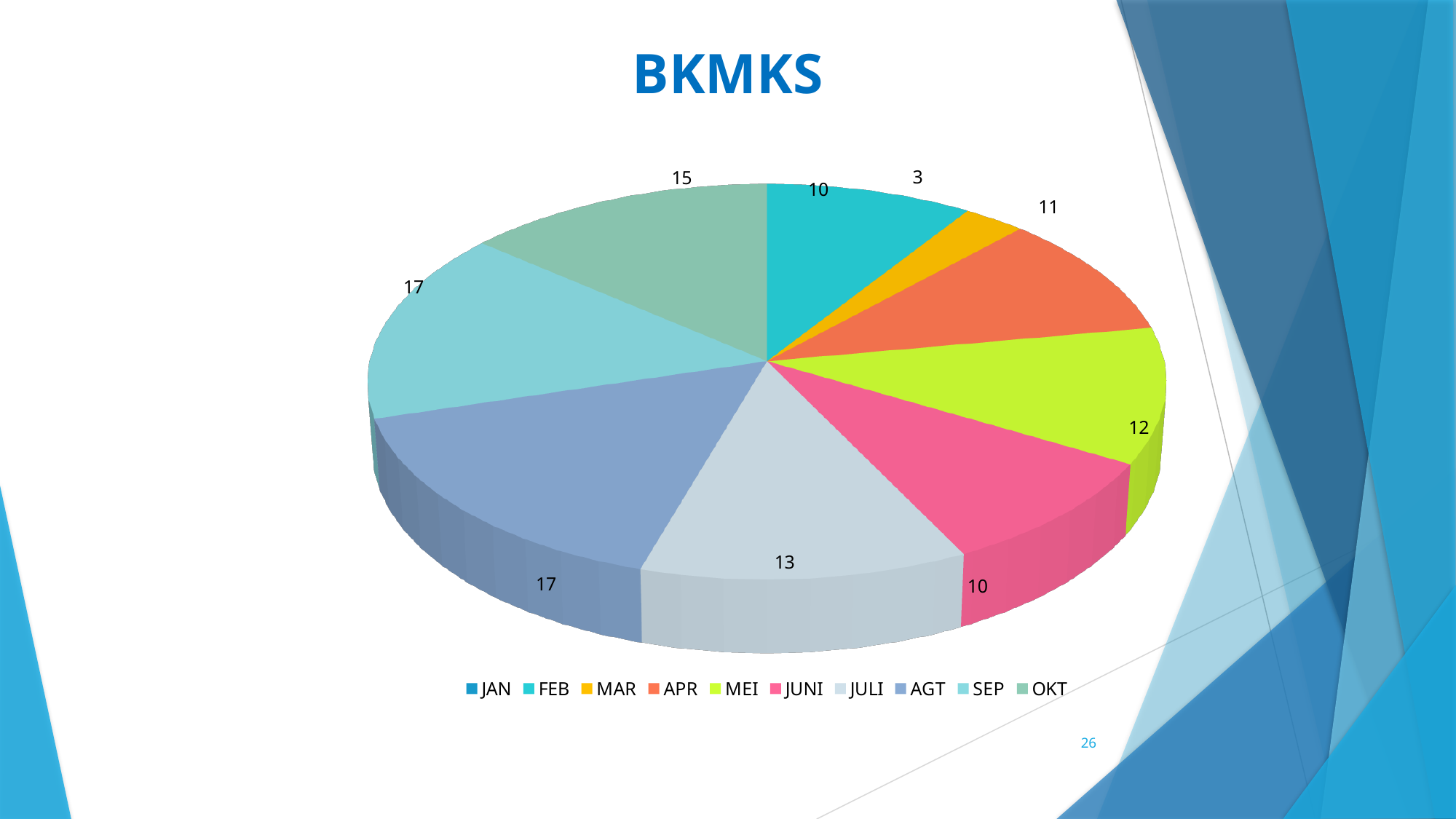
Which month has the smallest labeled slice in the pie chart? MAR Which is larger, the JULI slice or the JUNI slice? JULI What is the value of the APR slice? 11 What is the value of the OKT slice? 15 What type of chart is shown on the slide? pie chart How many categories does the legend list? 10 What is the difference between the OKT value and the FEB value? 5 What is the value of the JULI slice? 13 What is the difference between the AGT value and the MAR value? 14 What is the value of the MAR slice? 3 What is the title of the chart? BKMKS What is the value of the MEI slice? 12